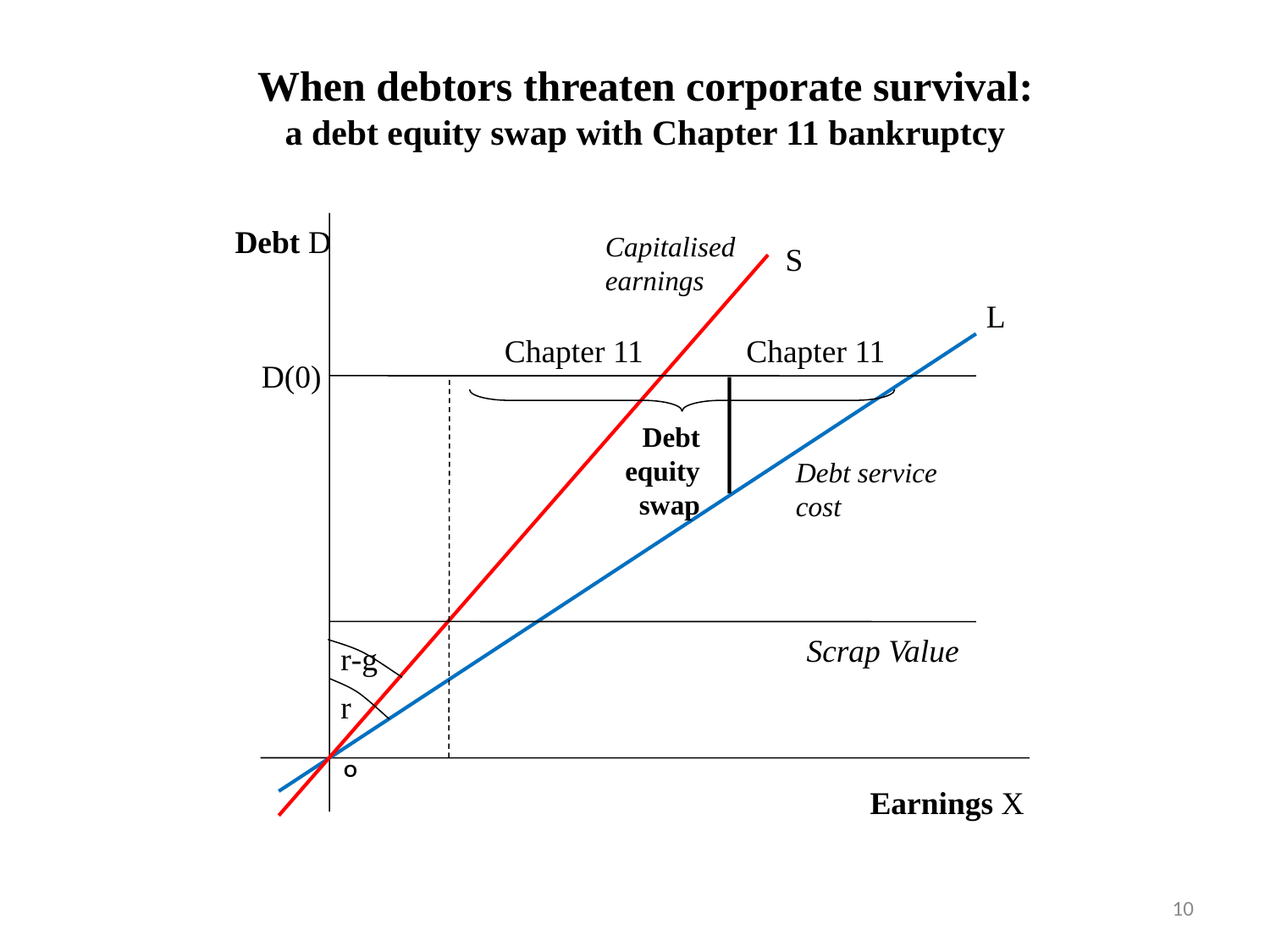
Which line is labelled "Capitalised earnings"? S What is the label of the horizontal axis? Earnings X What kind of chart is shown on the slide? line chart Does the red line S rise or fall as Earnings X increases? rise At which labelled point do lines S and L cross? o Does the blue line L rise or fall as Earnings X increases? rise Which of the two sloped lines, S or L, is steeper? S